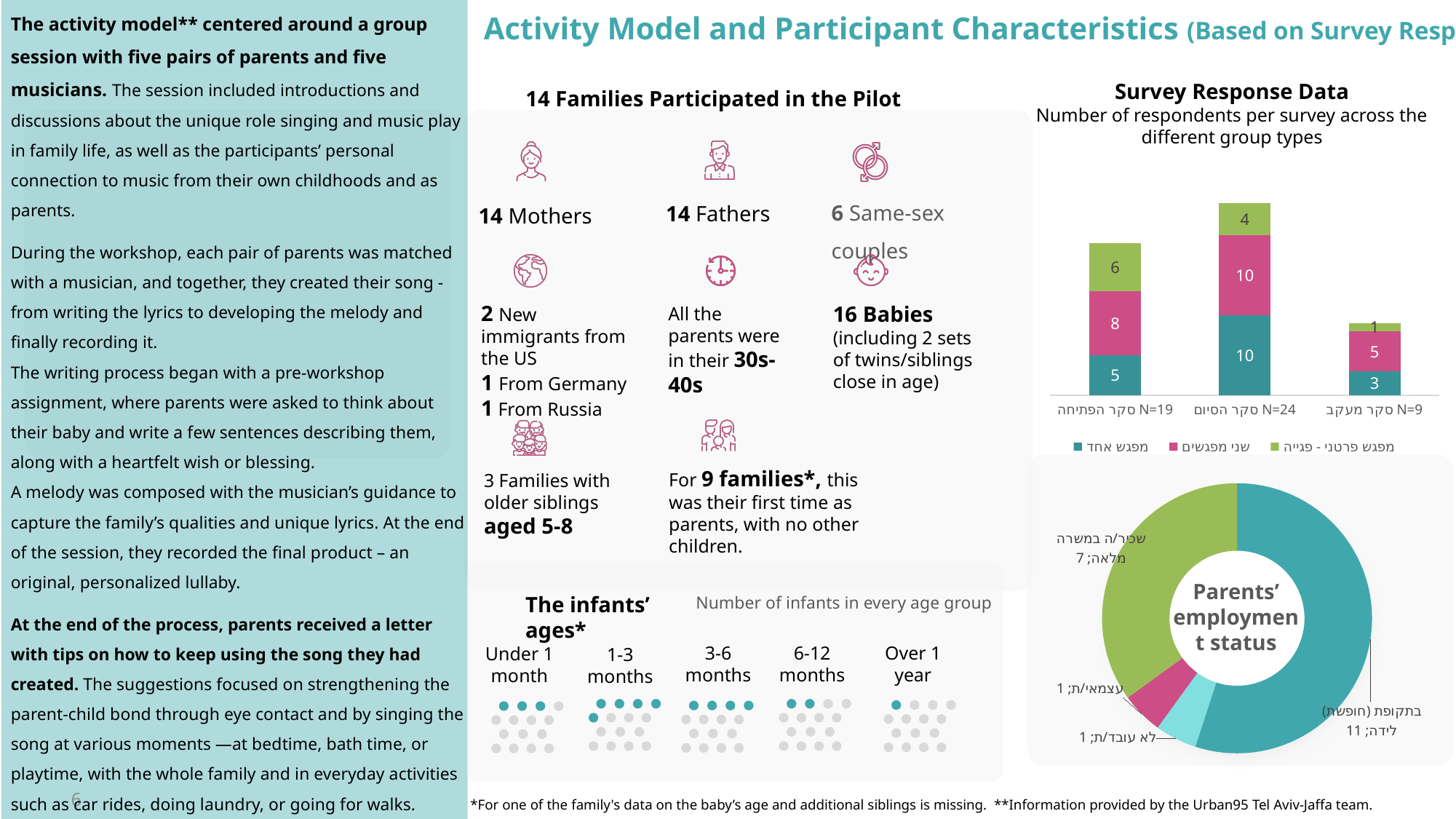
In the Parents' employment status chart, which category has the largest slice? בתקופת (חופשת) לידה In the Parents' employment status chart, how many parents are in the בתקופת (חופשת) לידה category? 11 In the Survey Response Data chart, what is the difference between the מפגש פרטני - פגייה values for סקר הפתיחה and סקר הסיום? 2 What type of chart is the Survey Response Data chart? Stacked bar chart How many series does the legend of the Survey Response Data chart list? 3 How many categories are shown in the Parents' employment status chart? 4 In the Parents' employment status chart, what share of the total does the שכיר/ה במשרה מלאה slice represent? 35% In the Survey Response Data chart, which survey has the lowest total number of respondents? סקר מעקב In the Survey Response Data chart, what is the total number of respondents for the סקר הסיום survey? 24 In the Survey Response Data chart, what is the value of the שני מפגשים segment for סקר מעקב? 5 In the Survey Response Data chart, what is the value of the מפגש אחד segment for סקר הפתיחה? 5 In the Survey Response Data chart, which survey has the highest total number of respondents? סקר הסיום